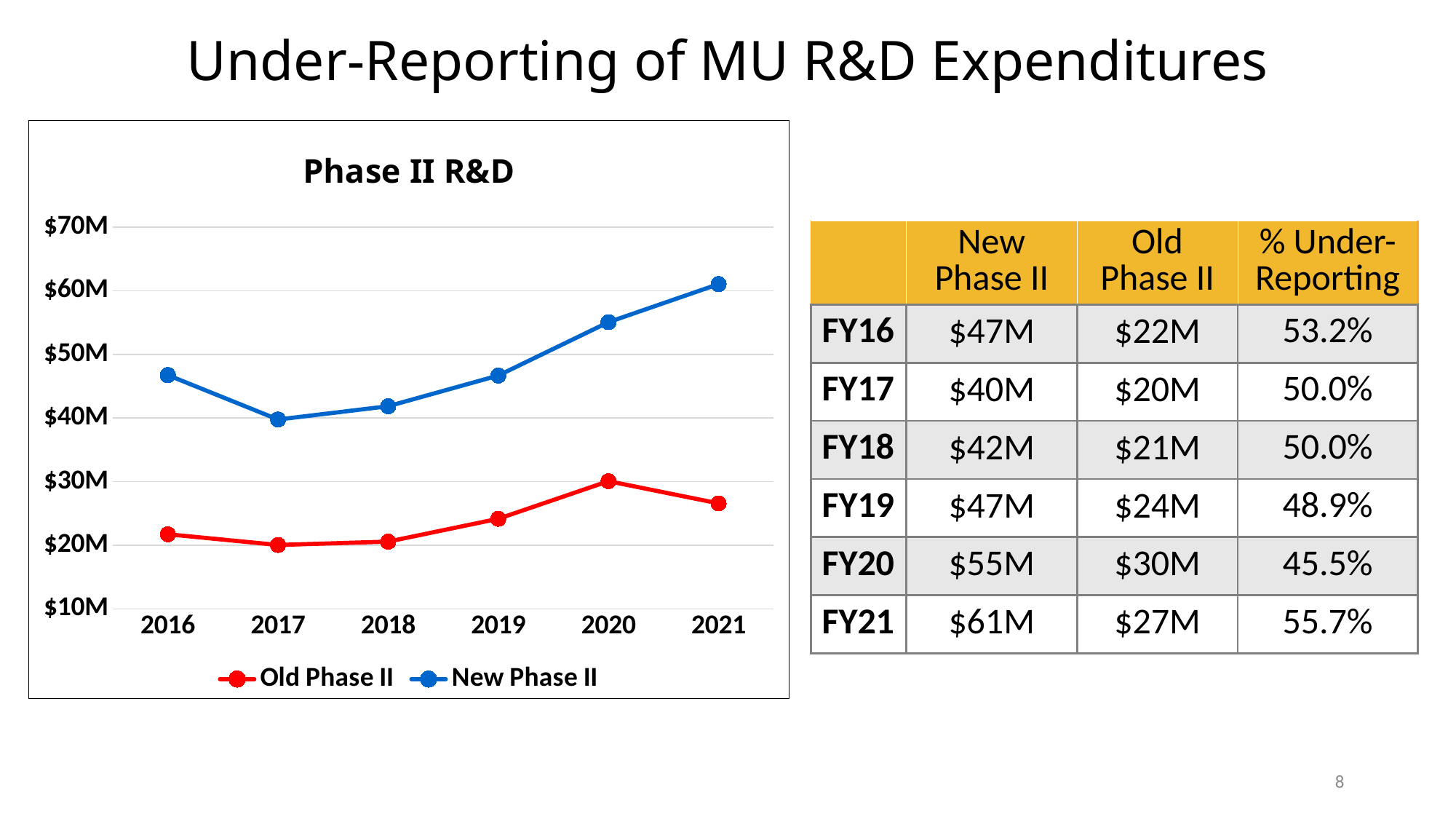
In which year is the New Phase II value highest? 2021 What is the title of the chart? Phase II R&D In which year is the Old Phase II value highest? 2020 How many series does the chart's legend list? 2 How many years are plotted along the x axis of the chart? 6 Is the New Phase II value for 2020 greater or less than $50M? greater What kind of chart is shown on the slide? line chart Does the New Phase II line rise or fall from 2017 to 2021? rise What colour is the Old Phase II line in the chart? red What is the Old Phase II value for 2020? $30M In which year is the New Phase II value lowest? 2017 What is the New Phase II value for 2017? $40M